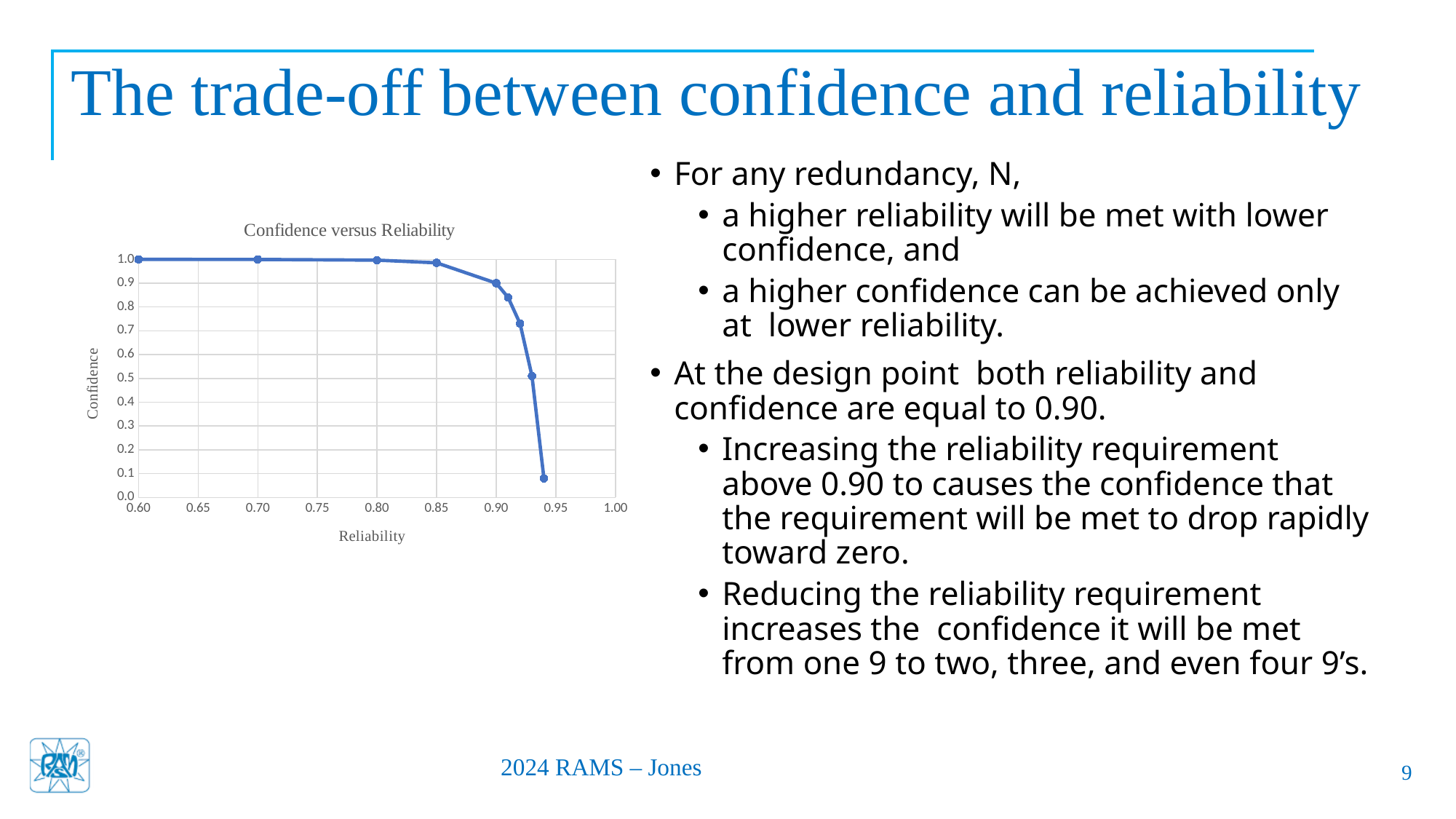
As reliability increases along the x axis, does confidence rise or fall? fall What is the highest value shown on the y axis of the chart? 1.0 What is the label of the x axis of the chart? Reliability What is the title of the chart? Confidence versus Reliability Which is larger: the confidence at reliability 0.85 or the confidence at reliability 0.90? 0.85 Is the confidence at the rightmost plotted point (near reliability 0.94) greater or less than 0.2? less Is the confidence at a reliability of 0.60 greater or less than 0.9? greater What kind of chart is shown on the slide? line chart Is the confidence at a reliability of 0.90 greater or less than 0.8? greater Is confidence lower at the lowest reliability plotted or at the highest reliability plotted? highest reliability